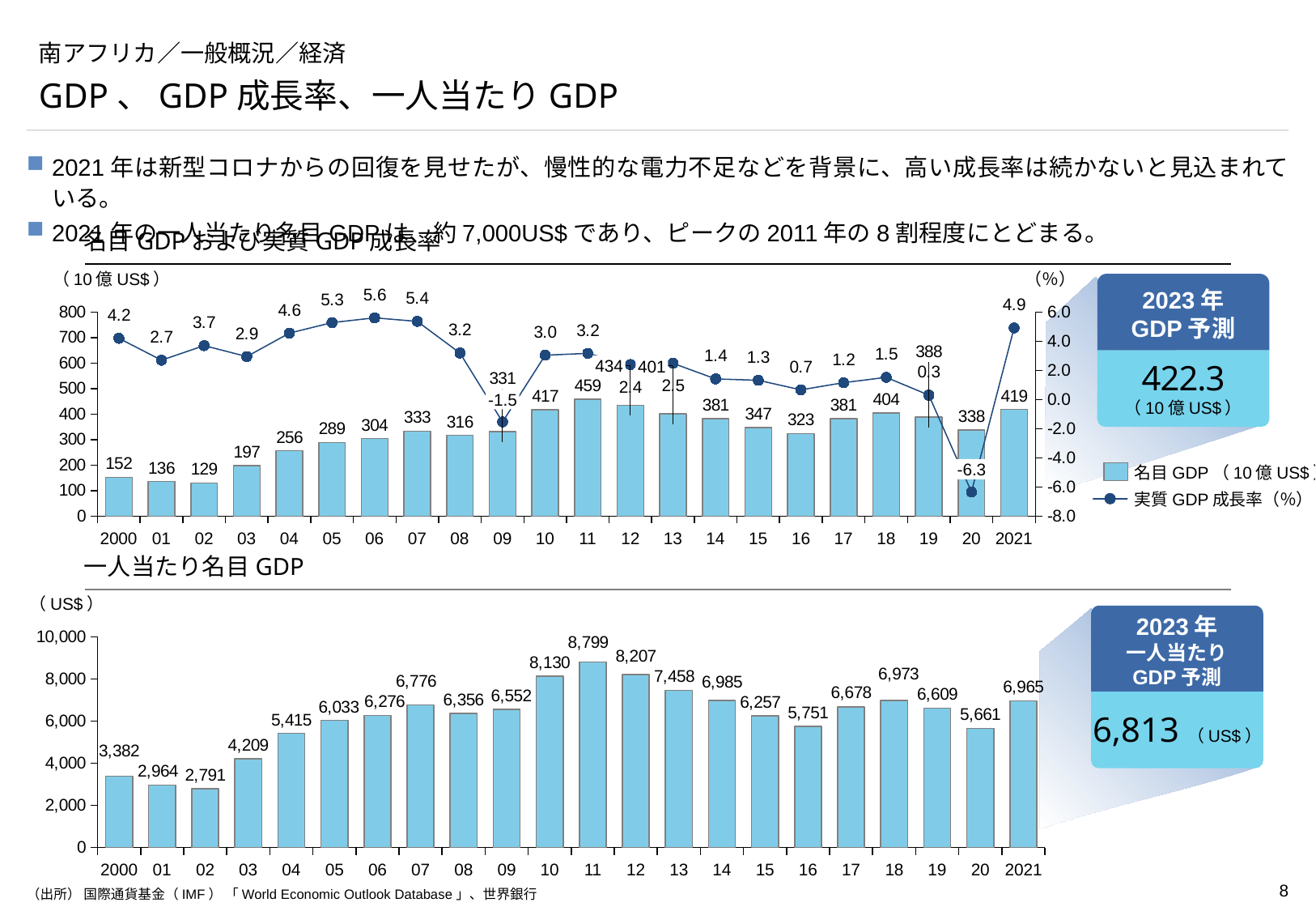
In the top chart (名目GDPおよび実質GDP成長率), which year has the highest real GDP growth rate? 06 In the top chart (名目GDPおよび実質GDP成長率), what is the real GDP growth rate for 2020? -6.3 In the top chart (名目GDPおよび実質GDP成長率), how many series does the legend list? 2 In the bottom chart (一人当たり名目GDP), what is the difference between the values for 10 and 09? 1,578 In the bottom chart (一人当たり名目GDP), which year has the lowest value? 02 In the bottom chart (一人当たり名目GDP), how many years are plotted? 22 What type of chart is the bottom chart (一人当たり名目GDP)? Bar chart In the top chart (名目GDPおよび実質GDP成長率), what is the difference in nominal GDP between 2021 and 20? 81 In the bottom chart (一人当たり名目GDP), which is larger, the value for 18 or the value for 2021? 18 In the top chart (名目GDPおよび実質GDP成長率), which year has the lowest nominal GDP? 02 In the bottom chart (一人当たり名目GDP), what is the value for 2011? 8,799 In the top chart (名目GDPおよび実質GDP成長率), what is the nominal GDP value for 2011? 459